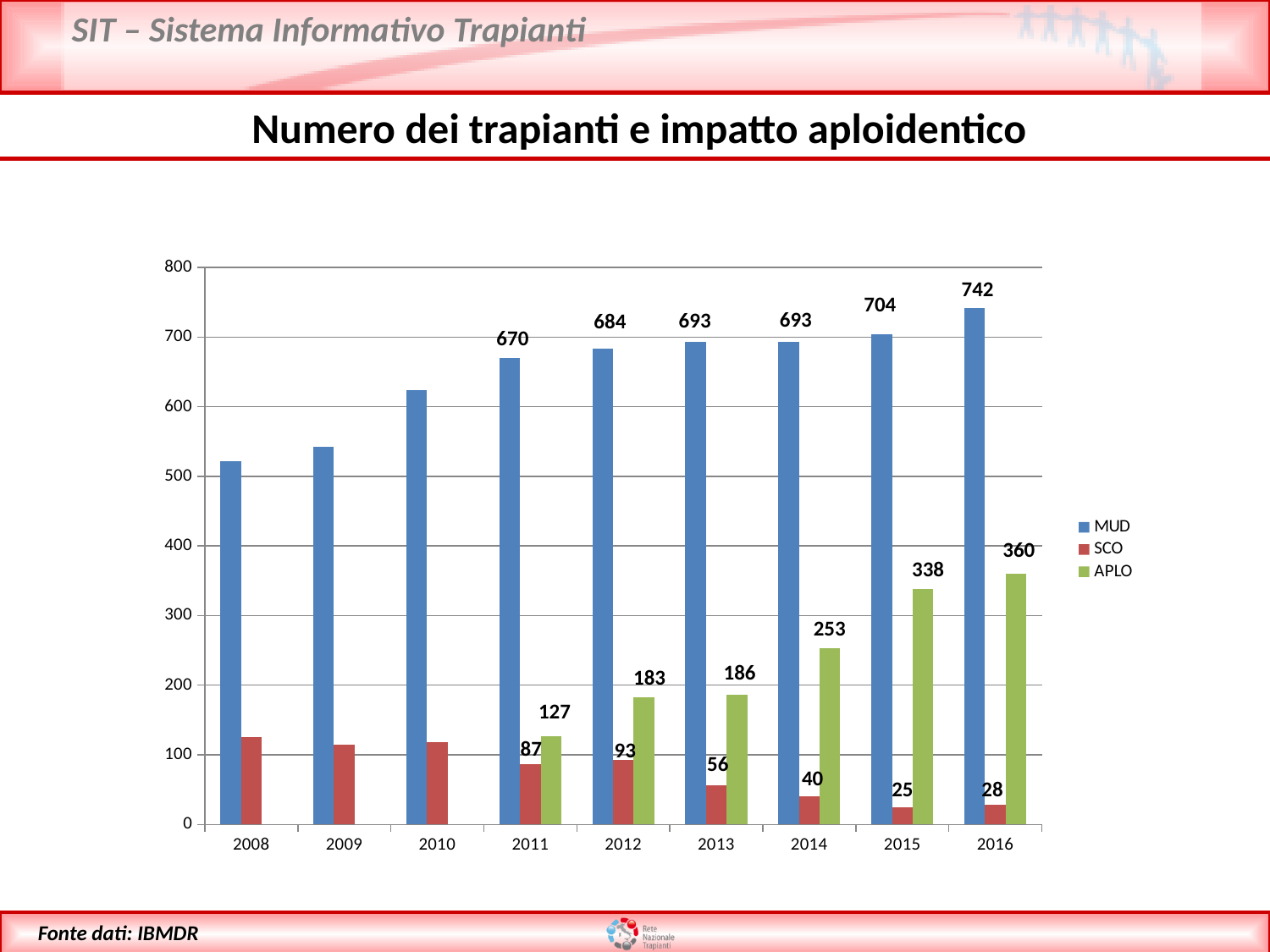
How many years are shown on the x axis? 9 Which year has the lowest MUD value? 2008 What kind of chart is shown on the slide? bar chart How many series does the legend list? 3 Which is larger, the SCO value for 2011 or the SCO value for 2012? 2012 What is the difference between the APLO values for 2016 and 2015? 22 Do the APLO values rise or fall from 2011 to 2016? rise Is the MUD value for 2010 greater or less than 600? greater What is the SCO value for 2013? 56 Which year has the highest APLO value? 2016 What is the MUD value for 2016? 742 What is the APLO value for 2014? 253